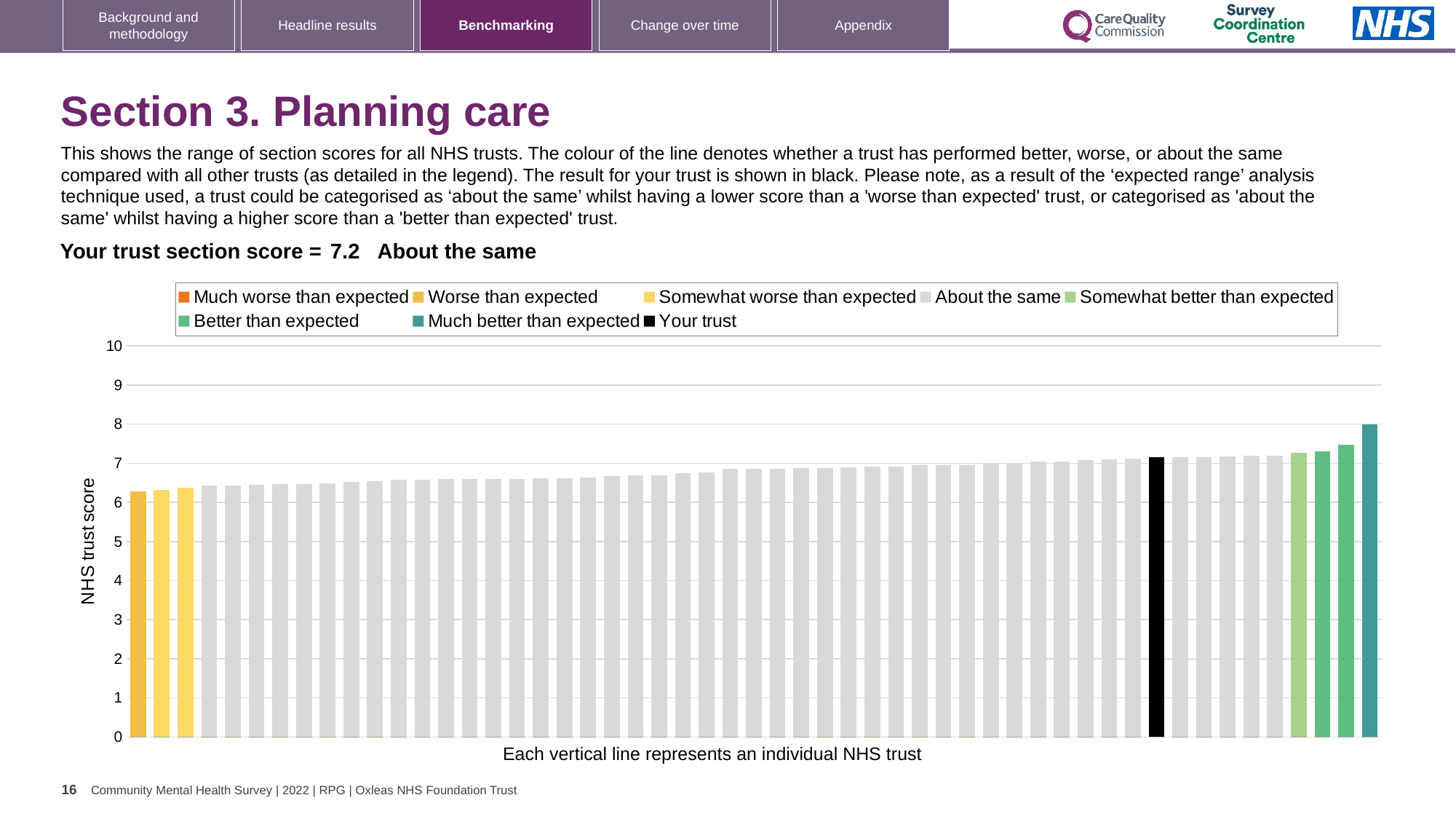
What colour is used for the bar representing your trust? black Which category is your trust placed in for this section? About the same Which is taller, the leftmost bar or the rightmost bar? the rightmost bar How many entries does the chart legend list? 8 Which legend category does the tallest bar belong to? Much better than expected Do the bar values rise or fall from left to right along the x axis? rise What is the section score for your trust shown on the slide? 7.2 Is the value for your trust (the black bar) greater or less than 6? greater What is the label on the vertical axis of the chart? NHS trust score What kind of chart is shown on the slide? bar chart Is the value of the leftmost bar greater or less than 5? greater Is the value of the tallest bar (the rightmost bar) greater or less than 7? greater